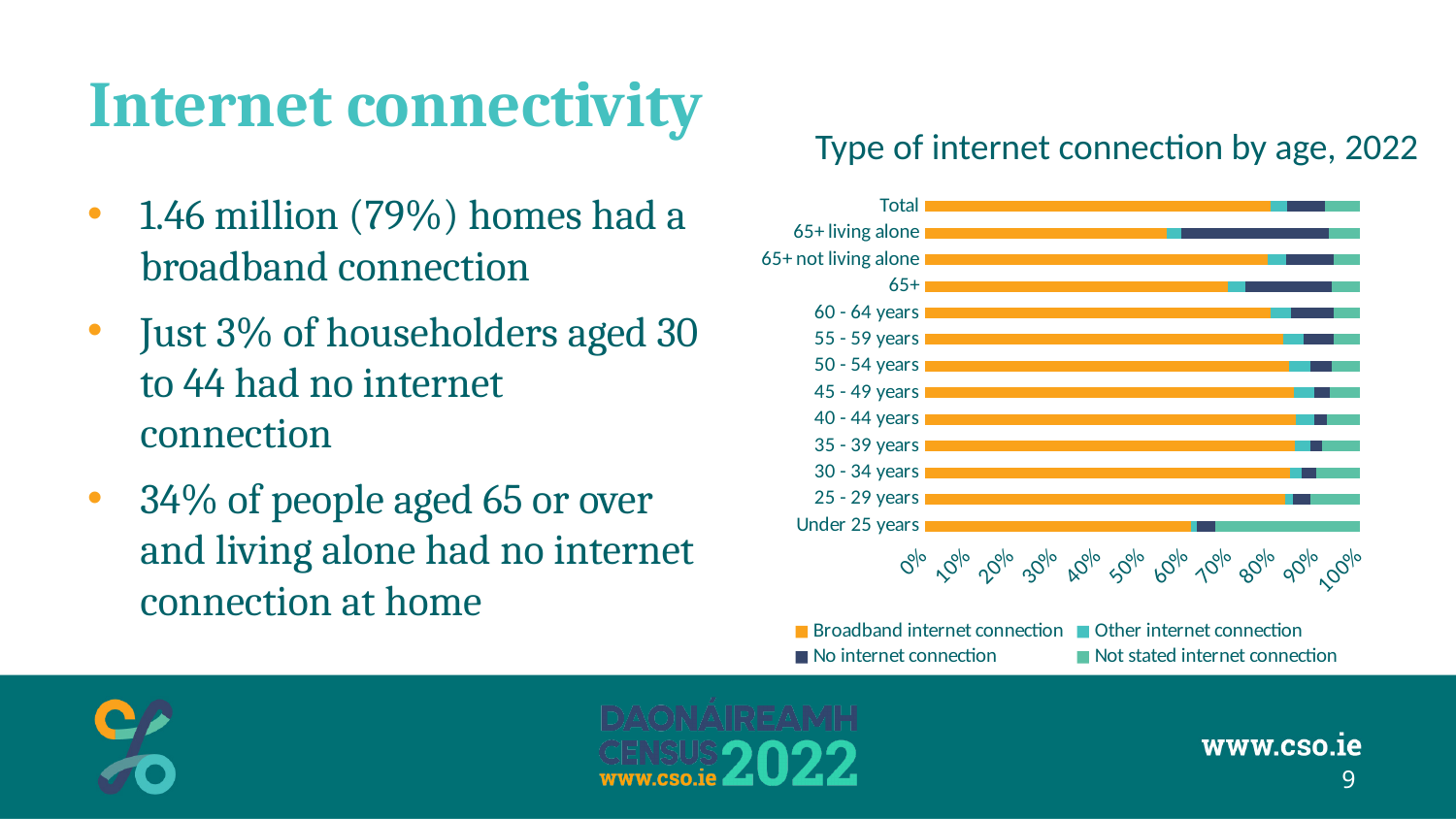
Is the broadband internet connection share for Under 25 years greater or less than 70%? less How many age categories are plotted on the chart? 13 Which has a larger broadband internet connection share, Under 25 years or Total? Total How many series does the chart's legend list? 4 Which series is shown in orange in the legend? Broadband internet connection Is the broadband internet connection share for Under 25 years greater or less than 50%? greater Which has a larger broadband internet connection share, 65+ or 40 - 44 years? 40 - 44 years Which category has the largest 'Not stated internet connection' segment? Under 25 years What is the title of the chart? Type of internet connection by age, 2022 What kind of chart is shown on the slide? Stacked bar chart Is the broadband internet connection share for Total greater or less than 70%? greater Which category has the largest 'No internet connection' segment? 65+ living alone